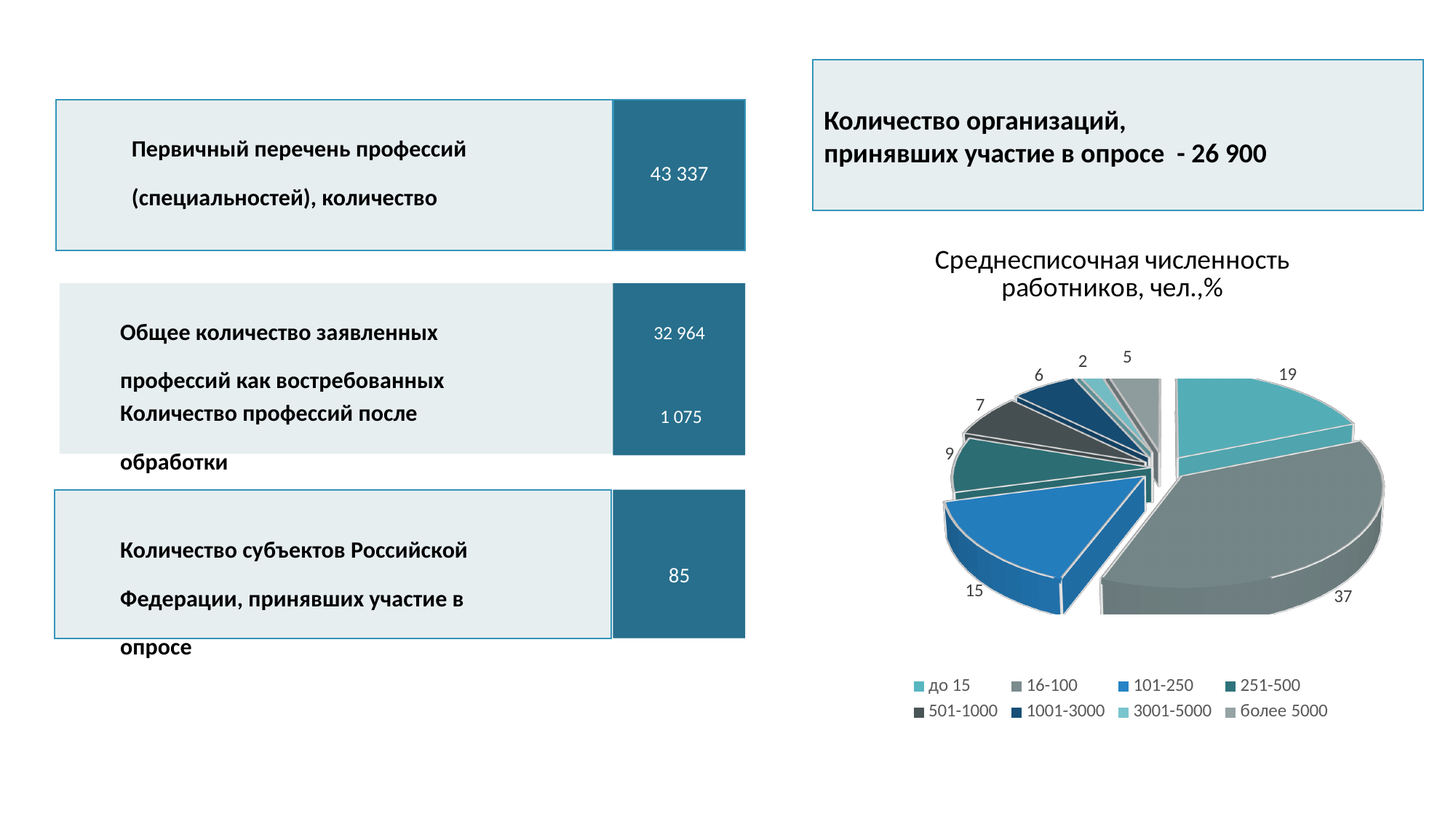
Which category has the smallest slice in the pie chart? 3001-5000 What is the title of the pie chart? Среднесписочная численность работников, чел.,% How many slices does the pie chart have? 8 What is the difference between the '16-100' and 'до 15' values in the pie chart? 18 How many entries does the legend of the pie chart list? 8 What is the value for the '101-250' slice in the pie chart? 15 Which category has the largest slice in the pie chart? 16-100 What kind of chart is shown on the slide? pie chart What is the value for the '16-100' slice in the pie chart? 37 Which is larger in the pie chart: '251-500' or '501-1000'? 251-500 What is the value for the '3001-5000' slice in the pie chart? 2 What is the value for the 'до 15' slice in the pie chart? 19